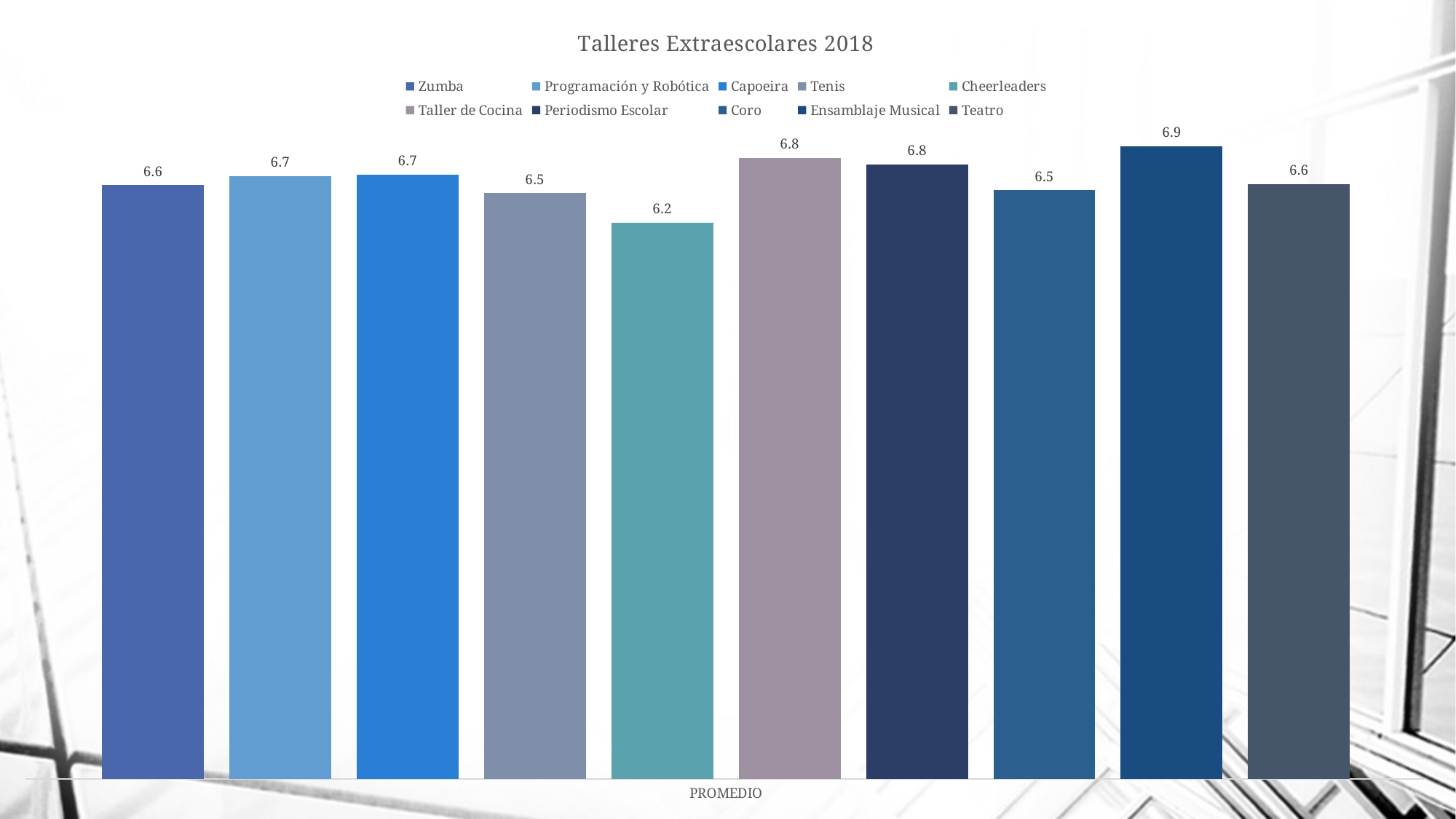
What is the difference between the values for Ensamblaje Musical and Cheerleaders? 0.7 Which is larger, the value for Periodismo Escolar or the value for Coro? Periodismo Escolar What is the title of the chart? Talleres Extraescolares 2018 How many series does the legend list? 10 What kind of chart is shown on the slide? Bar chart What is the value for Ensamblaje Musical? 6.9 Which workshop has the lowest value? Cheerleaders Which workshop has the highest value? Ensamblaje Musical What is the value for Cheerleaders? 6.2 What is the value for Zumba? 6.6 What is the label on the x axis under the bars? PROMEDIO What is the value for Taller de Cocina? 6.8